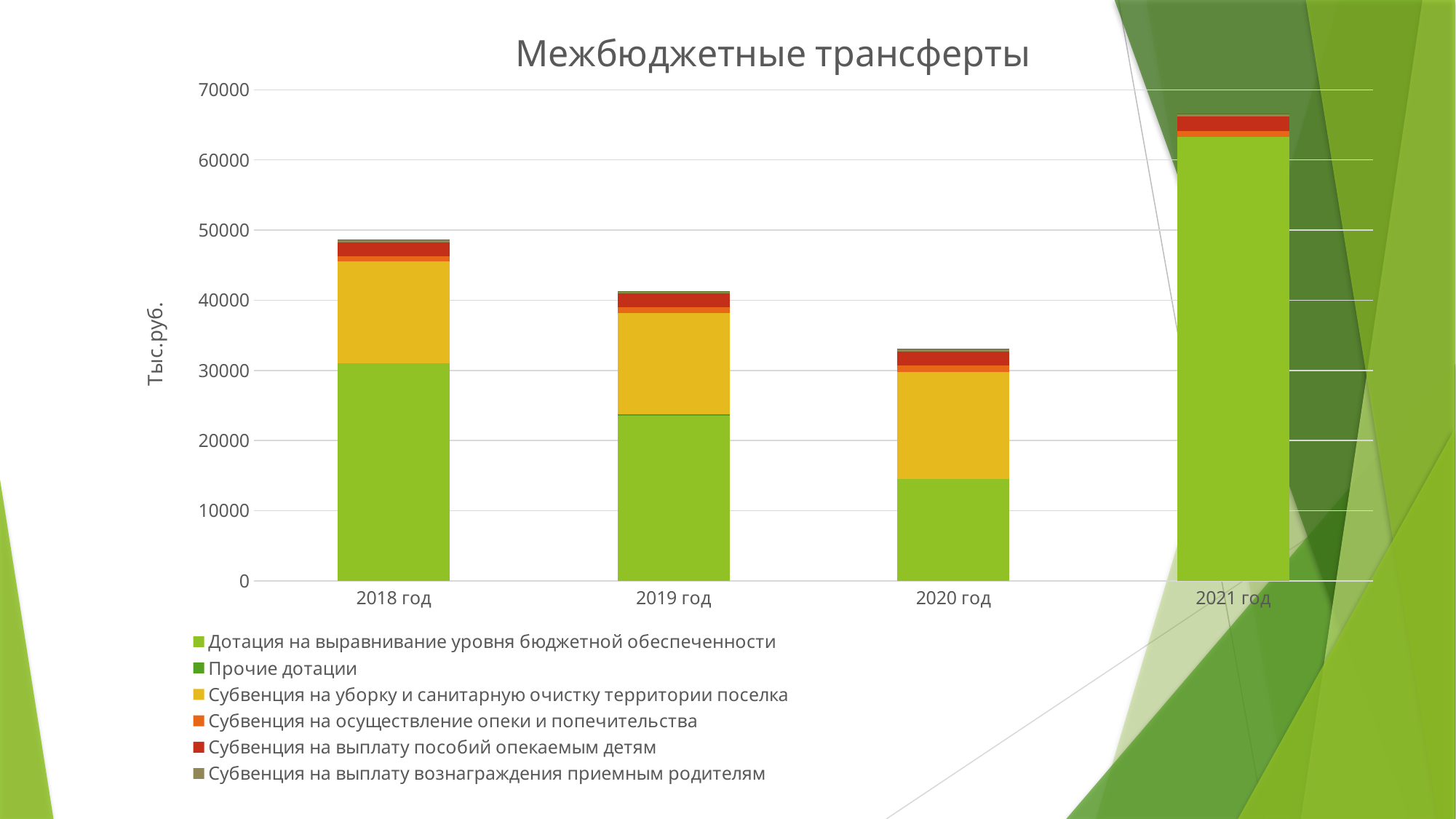
What is the label of the vertical axis? Тыс.руб. How many series does the legend list? 6 How many years (categories) are shown on the x axis? 4 Which year has the highest total stacked bar? 2021 год Is the total for 2018 год greater or less than 50000? less Which year has the lowest total stacked bar? 2020 год What is the title of the chart? Межбюджетные трансферты Is the total for 2021 год greater or less than 60000? greater Is the value of Дотация на выравнивание уровня бюджетной обеспеченности for 2020 год greater or less than 20000? less What kind of chart is shown on the slide? stacked bar chart Do the total stacked bars rise or fall from 2018 год to 2020 год? fall Which year has the larger value for Дотация на выравнивание уровня бюджетной обеспеченности, 2018 год or 2019 год? 2018 год